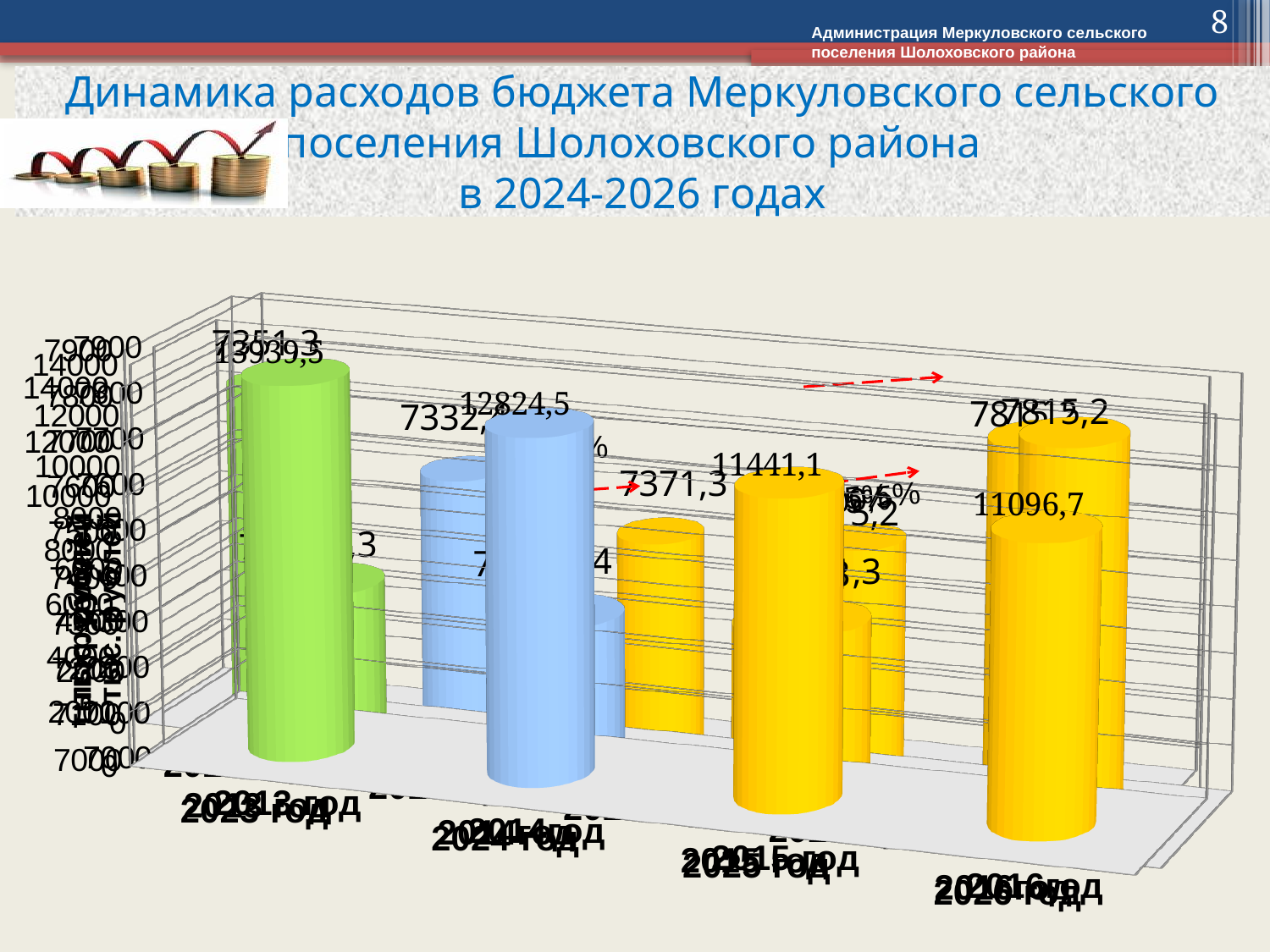
How many year categories are shown along the x axis of the chart? 4 In the front (largest) chart, is the value for 2026 год greater or less than 10000? greater In the front (largest) chart, what is the value labelled for 2026 год? 11096,7 In the front (largest) chart, which year has the lowest value? 2026 год In the front (largest) chart, what is the value labelled for 2024 год? 12824,5 In the front (largest) chart, what is the value labelled for 2025 год? 11441,1 In the front (largest) chart, what is the difference between the values for 2025 год and 2026 год? 344,4 In the front (largest) chart, do the values rise or fall from 2024 год to 2026 год? fall What kind of chart is shown on the slide? bar chart In the front (largest) chart, which is larger, the value for 2025 год or for 2026 год? 2025 год What is the title of the slide's chart? Динамика расходов бюджета Меркуловского сельского поселения Шолоховского района в 2024-2026 годах